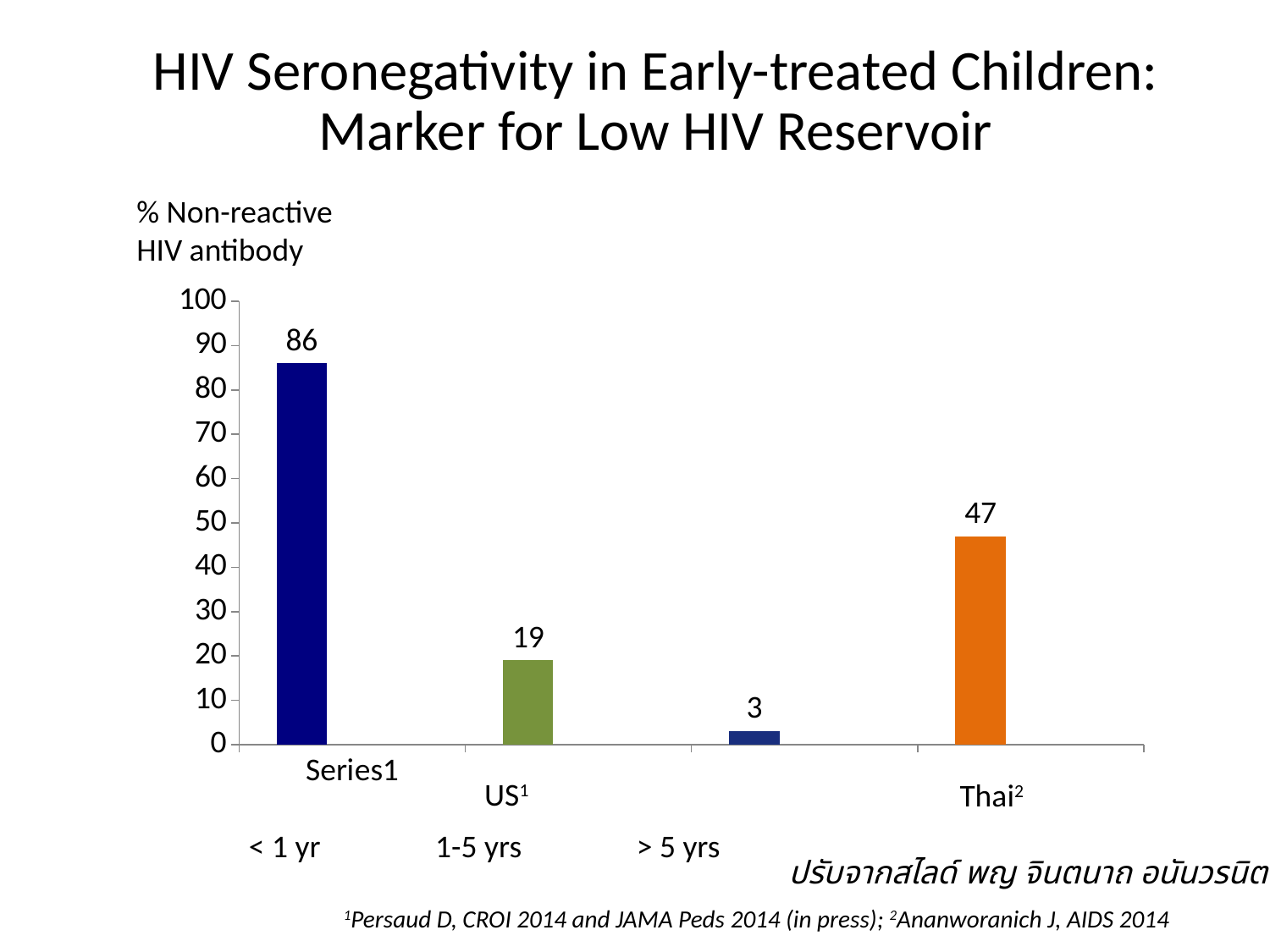
What is the value shown for the 1-5 yrs bar? 19 What is the difference between the < 1 yr value and the Thai value? 39 What is the value shown for the > 5 yrs bar? 3 What is the difference between the 1-5 yrs value and the > 5 yrs value? 16 What is the % non-reactive HIV antibody value for the < 1 yr bar? 86 Which is larger, the Thai value or the 1-5 yrs value? Thai What is the value shown for the Thai bar? 47 What kind of chart is shown on the slide? Bar chart How many bars are plotted in the chart? 4 What is the maximum value shown on the vertical axis? 100 Which bar has the highest value? < 1 yr Which bar has the lowest value? > 5 yrs